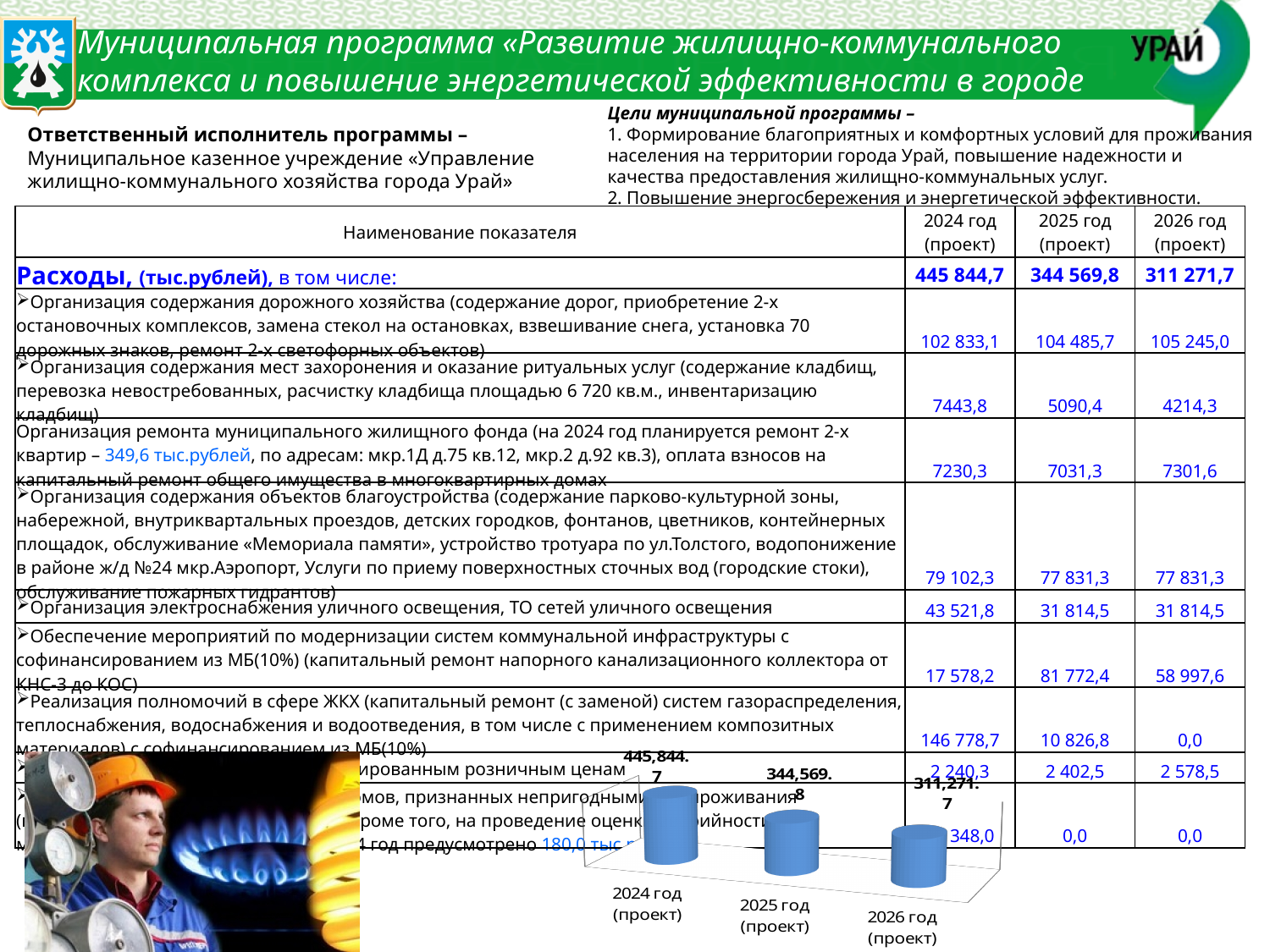
Which year has the lowest value in the chart? 2026 год (проект) Do the values in the chart rise or fall from 2024 to 2026? fall Which year has the highest value in the chart? 2024 год (проект) What is the value shown for 2026 год (проект) in the chart? 311,271.7 What is the difference between the values for 2025 год (проект) and 2026 год (проект) in the chart? 33,298.1 What is the difference between the values for 2024 год (проект) and 2025 год (проект) in the chart? 101,274.9 What is the value shown for 2025 год (проект) in the chart? 344,569.8 What is the value shown for 2024 год (проект) in the chart? 445,844.7 What kind of chart is shown at the bottom of the slide? bar chart Which is larger in the chart, the value for 2025 год (проект) or 2026 год (проект)? 2025 год (проект) How many categories are plotted in the chart? 3